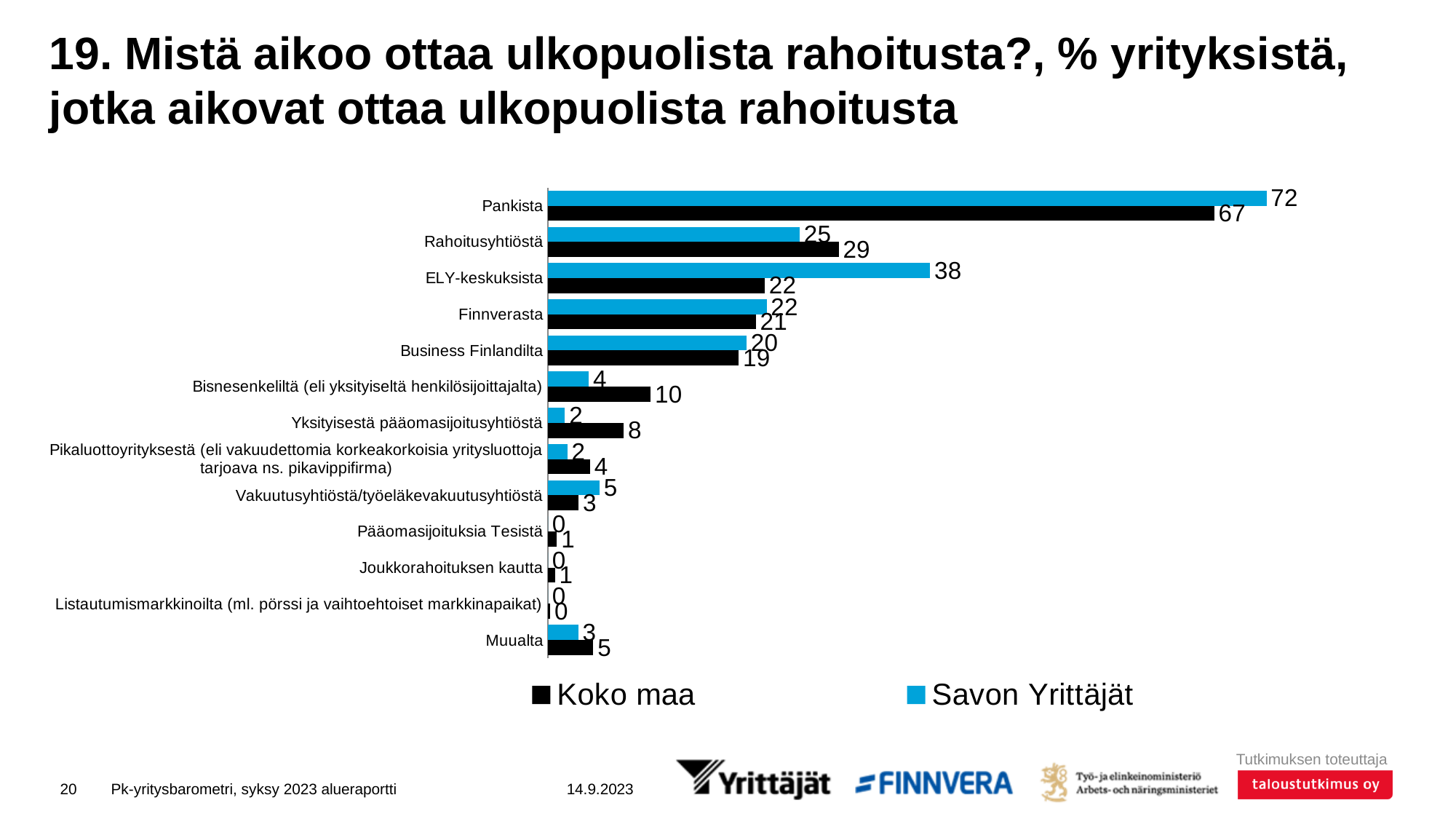
Which colour represents the Savon Yrittäjät series? Blue What is the difference between the Savon Yrittäjät and Koko maa values for ELY-keskuksista? 16 How many categories are shown on the chart? 13 Which category has the highest value for Koko maa? Pankista What is the value for Savon Yrittäjät for Bisnesenkeliltä (eli yksityiseltä henkilösijoittajalta)? 4 How many series does the legend list? 2 What is the difference between the Koko maa and Savon Yrittäjät values for Pankista? 5 For Yksityisestä pääomasijoitusyhtiöstä, which series has the larger value, Koko maa or Savon Yrittäjät? Koko maa What is the value for Savon Yrittäjät for Pankista? 72 For Rahoitusyhtiöstä, which series has the larger value, Koko maa or Savon Yrittäjät? Koko maa What kind of chart is shown on the slide? Bar chart What is the value for Koko maa for ELY-keskuksista? 22